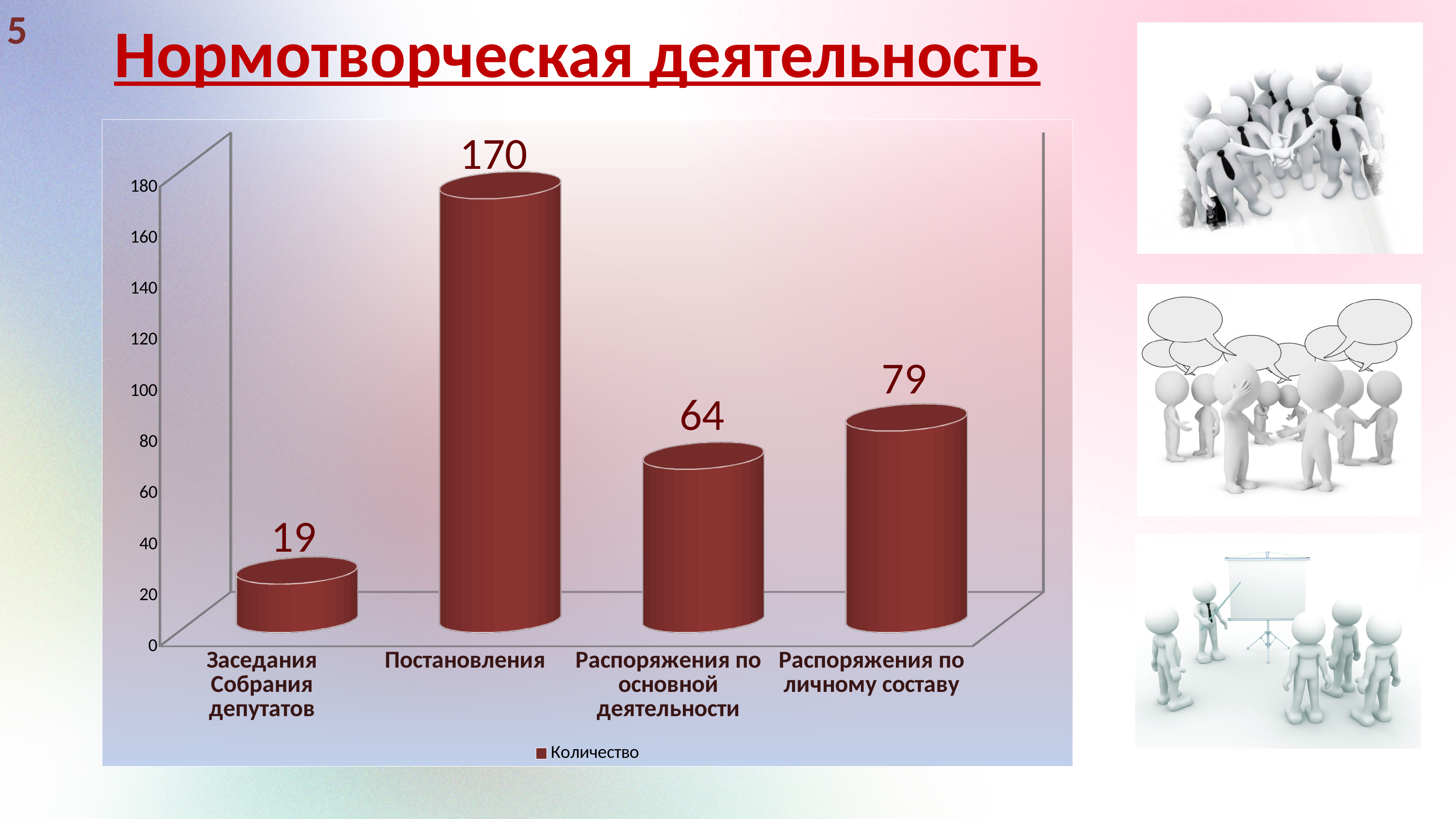
What is the value for Постановления? 170 Which category has the highest value? Постановления What kind of chart is shown on the slide? Bar chart Which category has the lowest value? Заседания Собрания депутатов What is the difference between the values for Постановления and Распоряжения по личному составу? 91 Which is larger: Распоряжения по основной деятельности or Распоряжения по личному составу? Распоряжения по личному составу What is the value for Распоряжения по основной деятельности? 64 What is the name of the series in the legend? Количество How many categories are shown on the chart? 4 How many series does the legend list? 1 What is the value for Распоряжения по личному составу? 79 What is the value for Заседания Собрания депутатов? 19